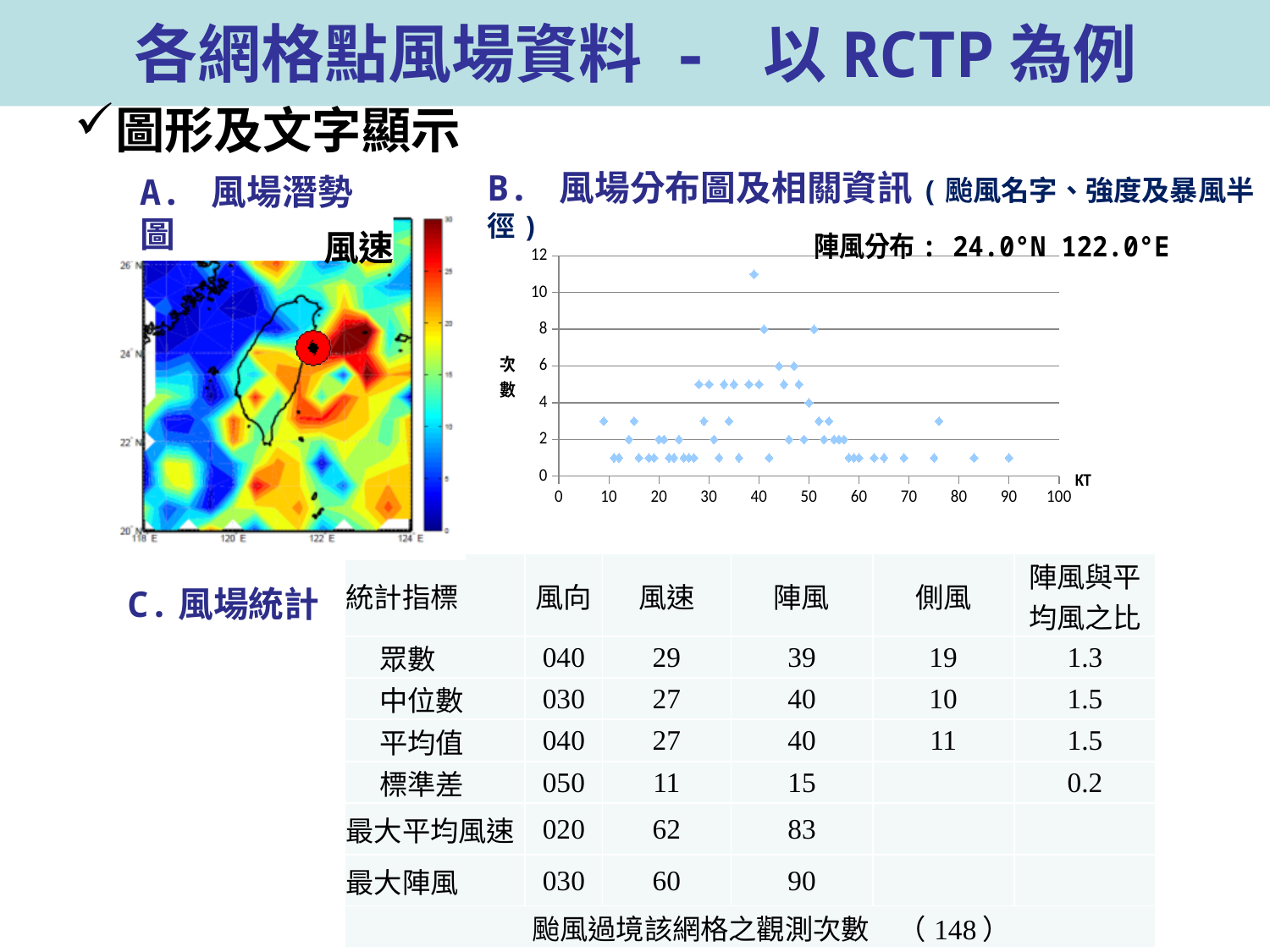
In the scatter chart 陣風分布： 24.0°N 122.0°E, is the highest point's count greater or less than 10? greater In the scatter chart 陣風分布： 24.0°N 122.0°E, is the highest point's count greater or less than 12? less In the scatter chart 陣風分布： 24.0°N 122.0°E, is the count for the point near 90 KT greater or less than 2? less What is the title of the scatter chart on the slide? 陣風分布： 24.0°N 122.0°E What kind of chart is the chart titled 陣風分布： 24.0°N 122.0°E? scatter chart In the scatter chart 陣風分布： 24.0°N 122.0°E, what unit is shown at the end of the x axis? KT